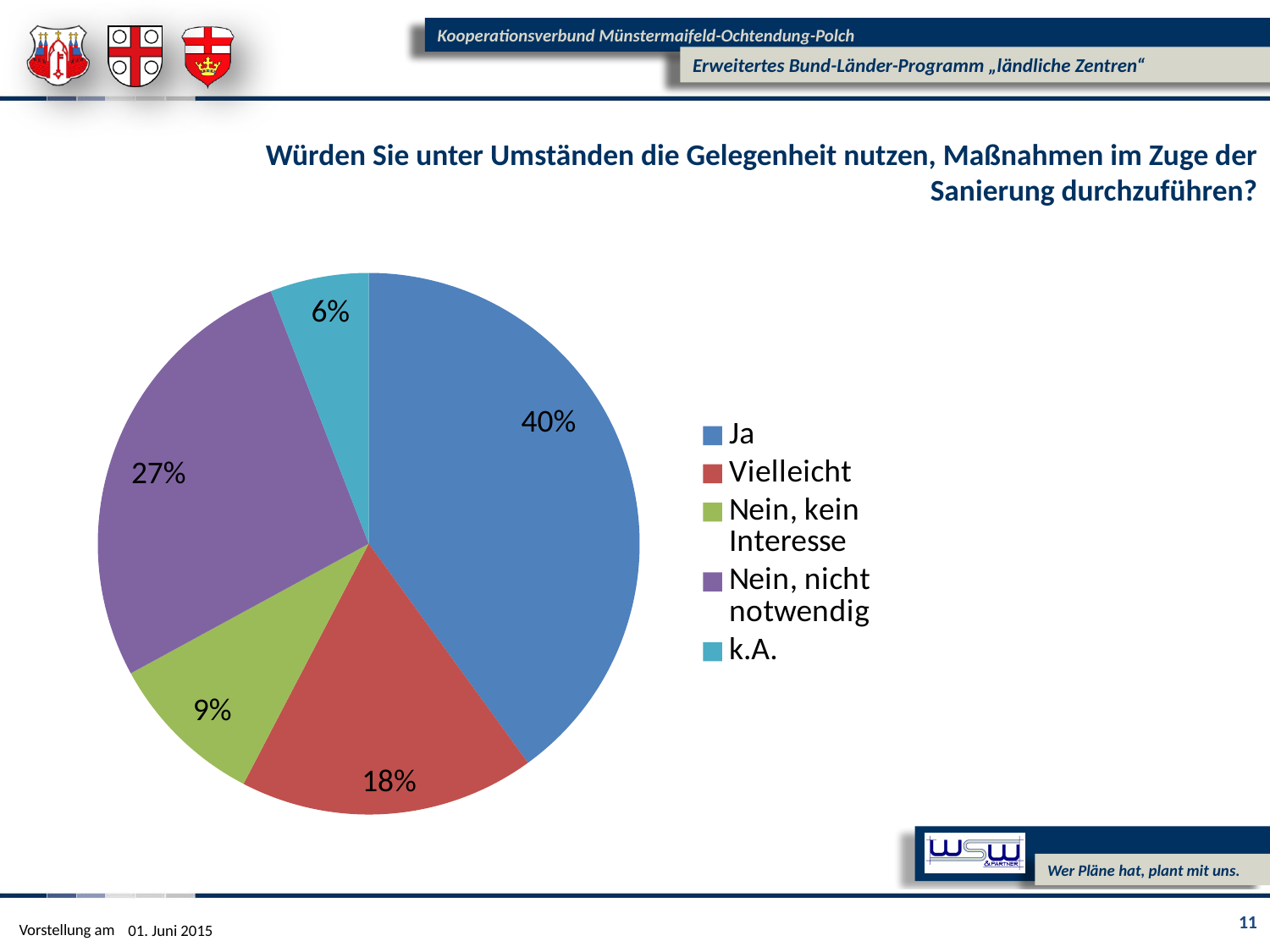
What is the value for "k.A."? 6% Which is larger, the share for "Vielleicht" or the share for "Nein, kein Interesse"? Vielleicht What is the value for "Vielleicht"? 18% Which category has the largest slice? Ja How many categories does the pie chart have? 5 What is the value for "Nein, nicht notwendig"? 27% What colour is the slice for "Nein, nicht notwendig"? purple What is the value for "Nein, kein Interesse"? 9% What kind of chart is shown on the slide? pie chart What is the difference between the shares of "Ja" and "Nein, nicht notwendig"? 13% What share of the pie does "Ja" have? 40% Which category has the smallest slice? k.A.